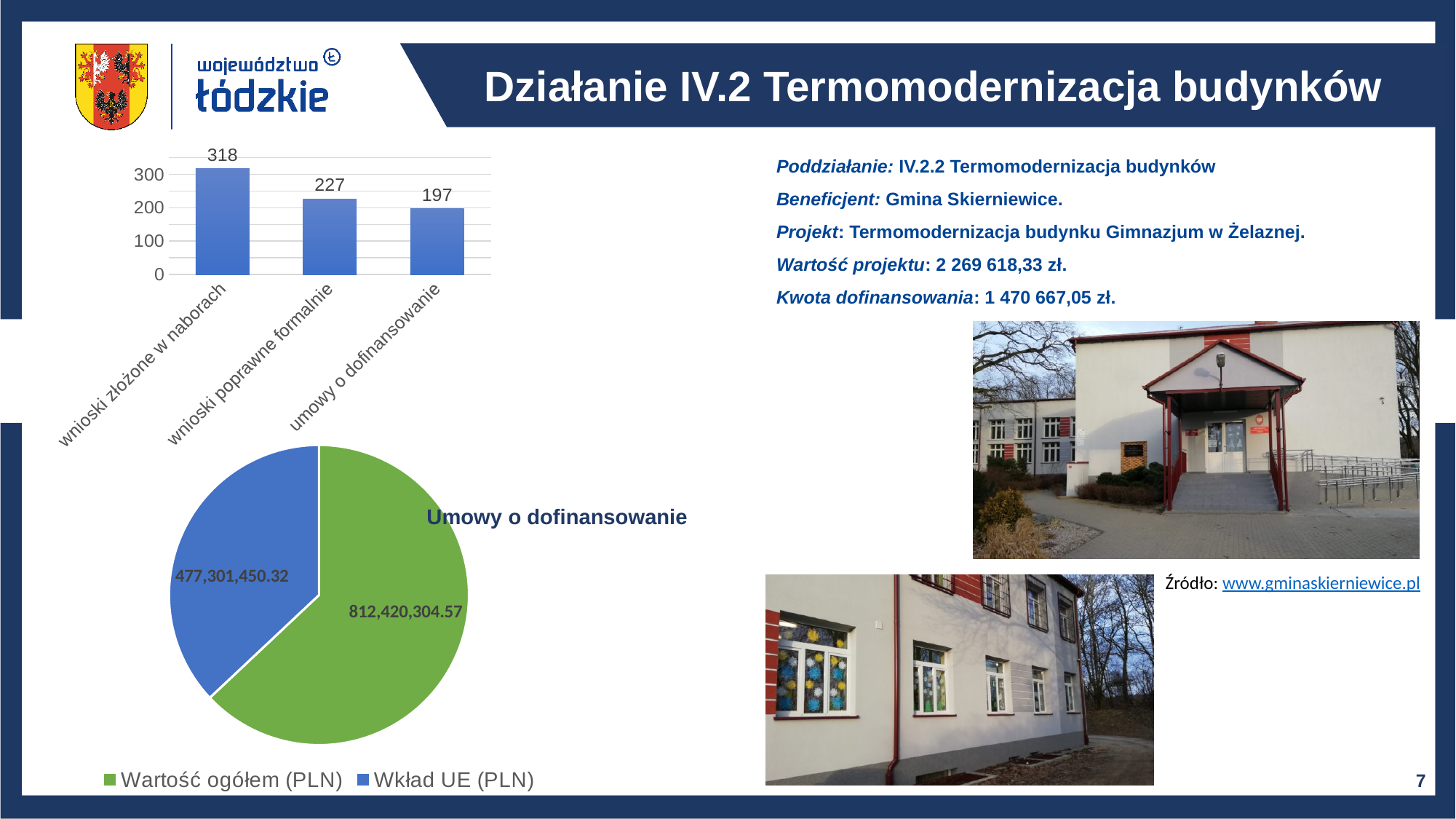
In the bar chart, do the values rise or fall from left to right along the x axis? fall In the bar chart, which category has the lowest value? umowy o dofinansowanie In the pie chart 'Umowy o dofinansowanie', which colour represents 'Wkład UE (PLN)'? blue In the bar chart, which category has the highest value? wnioski złożone w naborach In the bar chart, what is the value for 'wnioski poprawne formalnie'? 227 In the bar chart, what is the difference between 'wnioski poprawne formalnie' and 'umowy o dofinansowanie'? 30 In the bar chart, what is the value for 'wnioski złożone w naborach'? 318 In the bar chart, what is the value for 'umowy o dofinansowanie'? 197 How many categories does the bar chart show? 3 In the pie chart 'Umowy o dofinansowanie', what is the value for 'Wartość ogółem (PLN)'? 812,420,304.57 In the pie chart 'Umowy o dofinansowanie', what is the value for 'Wkład UE (PLN)'? 477,301,450.32 In the bar chart, what is the difference between 'wnioski złożone w naborach' and 'umowy o dofinansowanie'? 121